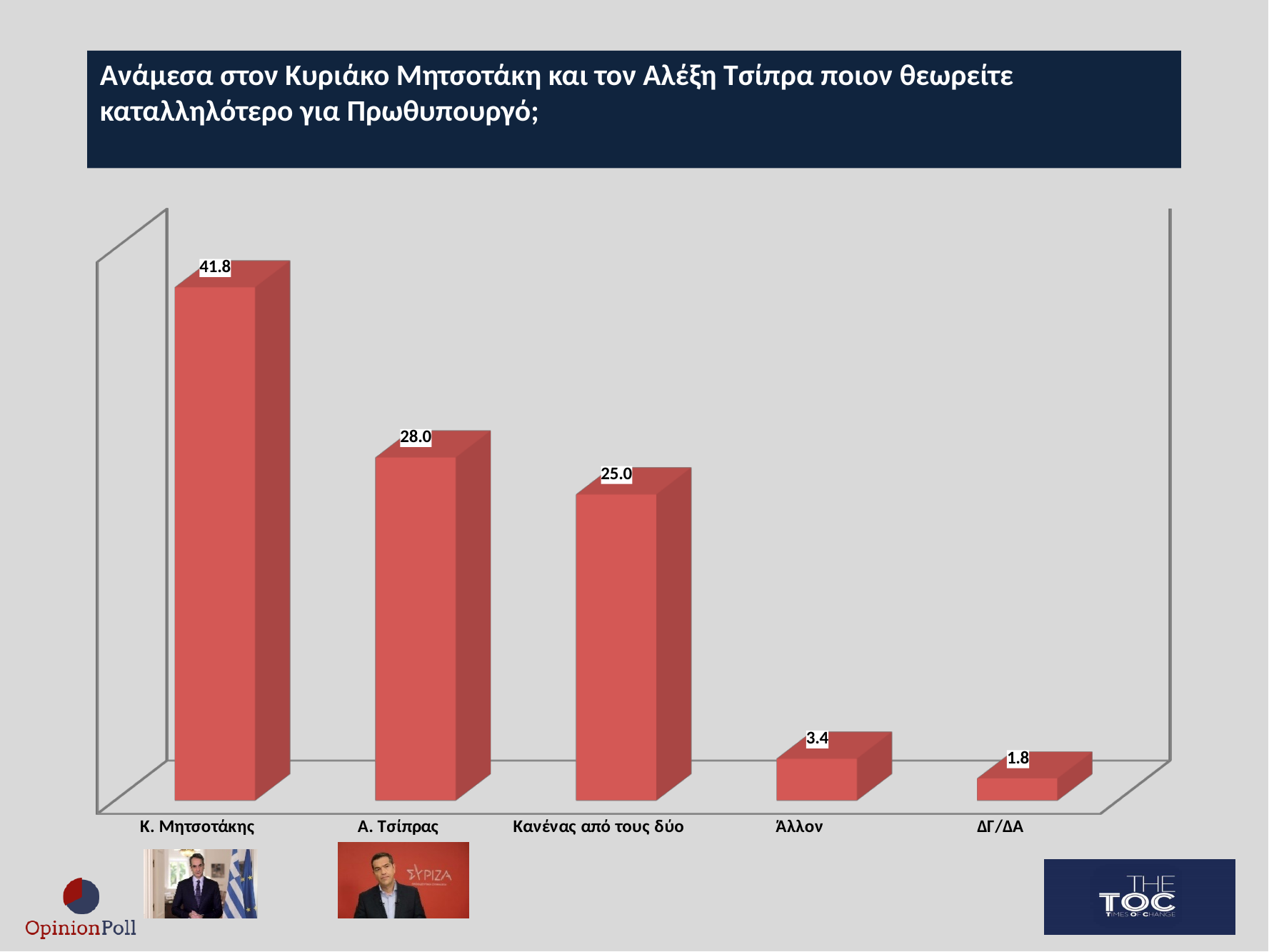
Which category has the highest value? Κ. Μητσοτάκης What is the value for ΔΓ/ΔΑ? 1.8 What is the difference between the values for Κ. Μητσοτάκης and Α. Τσίπρας? 13.8 Which is larger, the value for Άλλον or the value for ΔΓ/ΔΑ? Άλλον What kind of chart is shown on the slide? Bar chart Which category has the lowest value? ΔΓ/ΔΑ What is the value for Άλλον? 3.4 What is the value for Α. Τσίπρας? 28.0 What is the value for Κανένας από τους δύο? 25.0 What is the value for Κ. Μητσοτάκης? 41.8 How many categories are shown in the chart? 5 What is the difference between the values for Α. Τσίπρας and Κανένας από τους δύο? 3.0